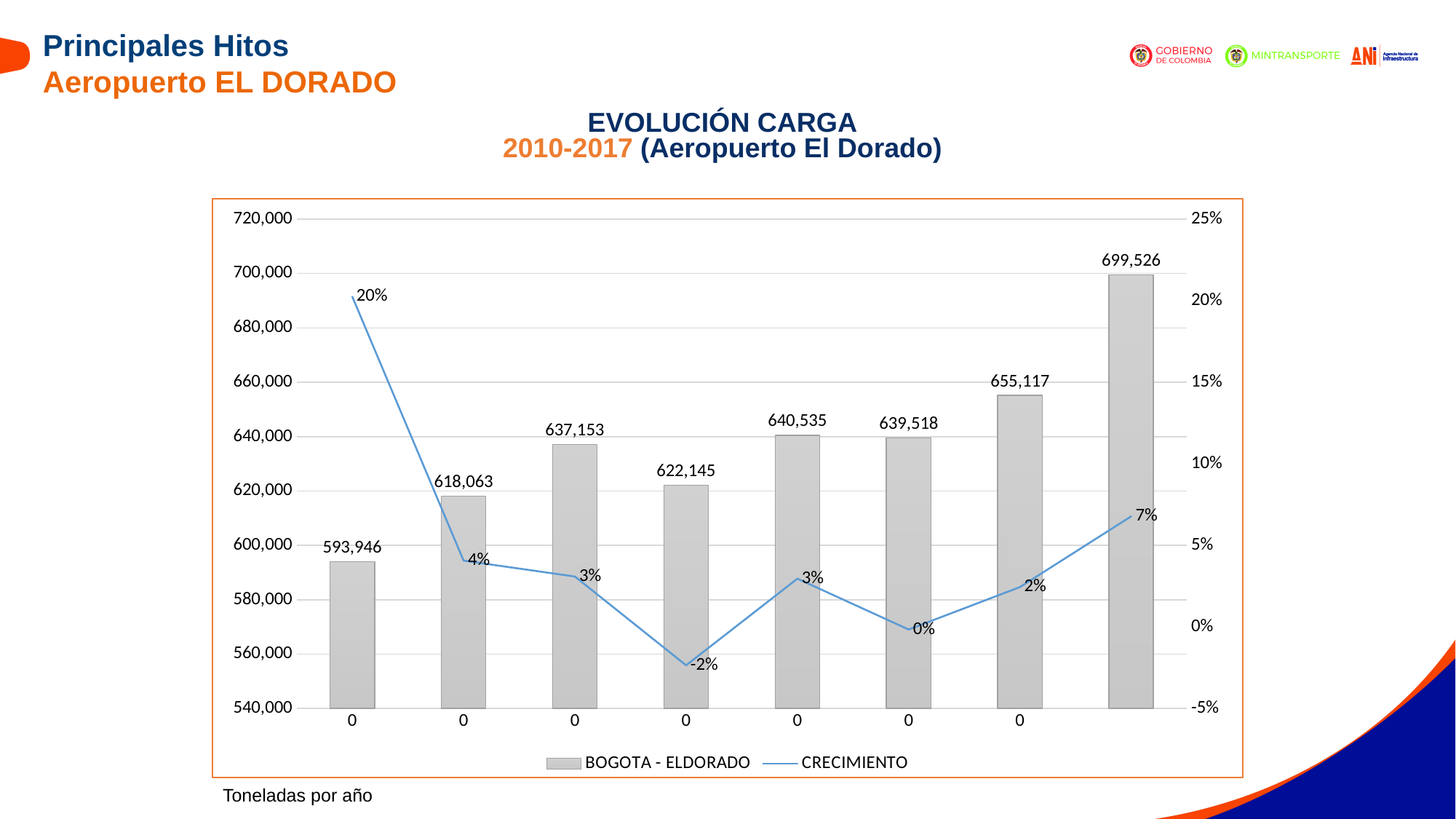
What unit is indicated below the chart? Toneladas por año How many series does the legend list? 2 What is the difference between the highest and lowest BOGOTA - ELDORADO bar values? 105,580 What is the value of the first (leftmost) bar in the BOGOTA - ELDORADO series? 593,946 Which is larger, the fifth bar (640,535) or the sixth bar (639,518)? The fifth bar (640,535) What is the lowest value on the CRECIMIENTO line? -2% How many bars are plotted for the BOGOTA - ELDORADO series? 8 What is the lowest value shown for the BOGOTA - ELDORADO bars? 593,946 What is the highest value shown for the BOGOTA - ELDORADO bars? 699,526 What is the highest value on the CRECIMIENTO line? 20% What type of chart is shown on the slide? Combined bar and line chart What is the value of the last (rightmost) bar in the BOGOTA - ELDORADO series? 699,526